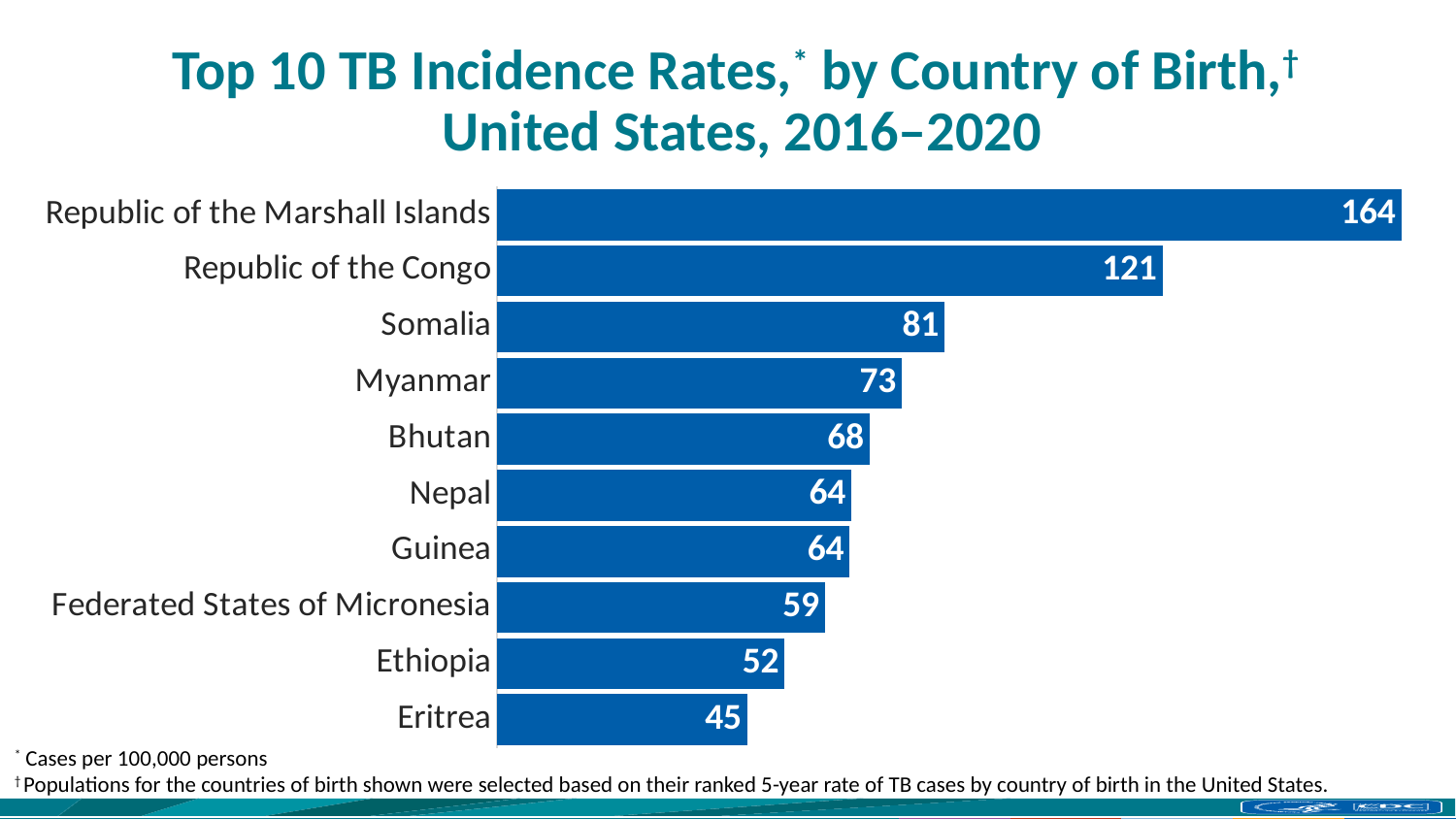
What is the TB incidence rate for the Federated States of Micronesia? 59 Which has a higher TB incidence rate, Somalia or Myanmar? Somalia What is the TB incidence rate for Somalia? 81 Which country of birth has the lowest TB incidence rate shown? Eritrea What kind of chart is shown on the slide? Bar chart What is the TB incidence rate for Ethiopia? 52 Which country of birth has the highest TB incidence rate? Republic of the Marshall Islands What is the difference between the TB incidence rates for Myanmar and Bhutan? 5 Which two countries of birth share the same TB incidence rate of 64? Nepal and Guinea What is the difference between the TB incidence rates for the Republic of the Marshall Islands and the Republic of the Congo? 43 According to the footnote, what unit are the TB incidence rates expressed in? Cases per 100,000 persons How many countries of birth are shown in the chart? 10